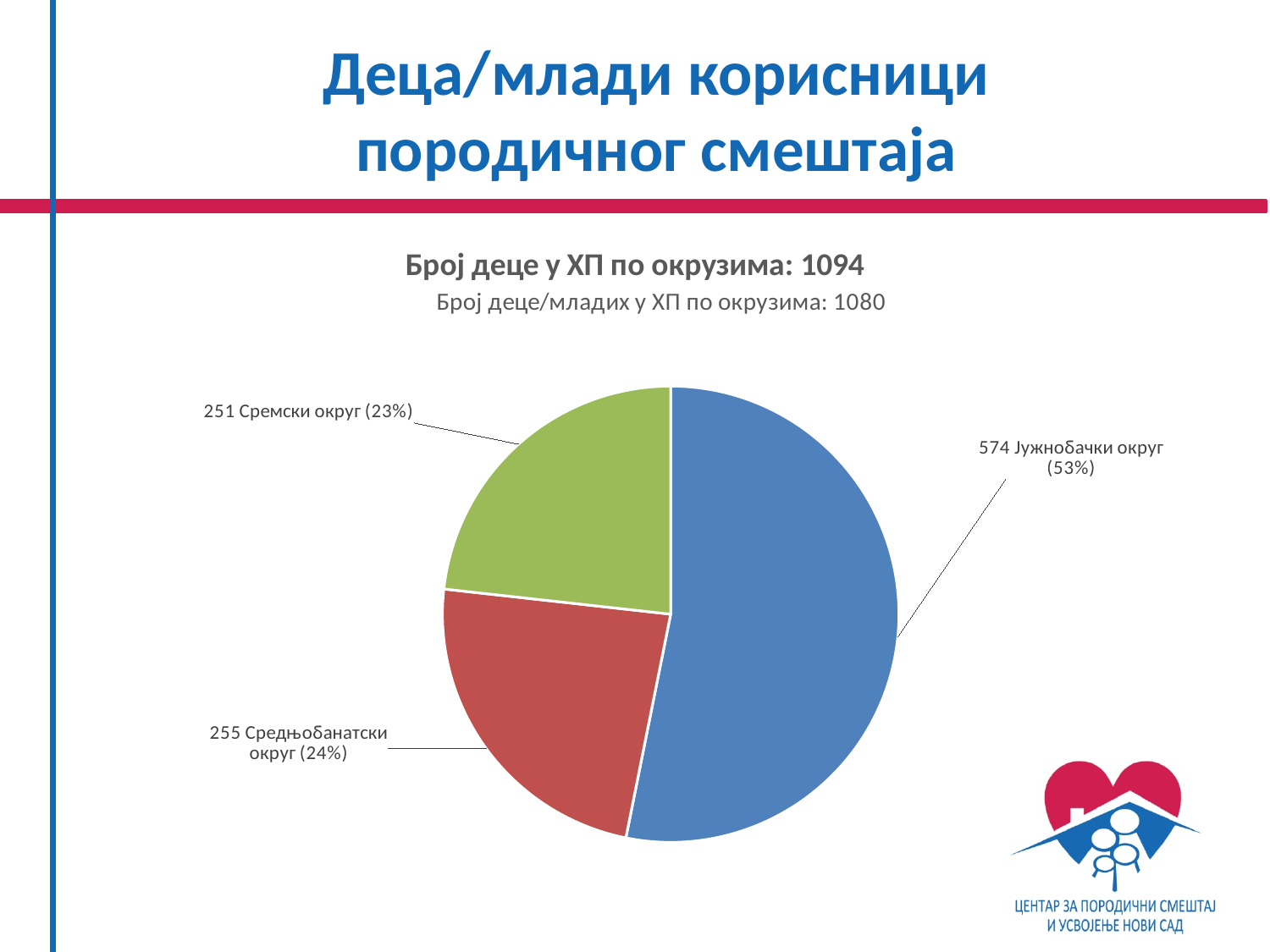
What is the difference between the values for Јужнобачки округ and Сремски округ? 323 What share of the pie does Јужнобачки округ represent? 53% What is the value for Сремски округ? 251 What is the value for Средњобанатски округ? 255 What kind of chart is shown on the slide? pie chart What is the value for Јужнобачки округ? 574 Which district has the largest slice of the pie? Јужнобачки округ Which district has the smallest slice of the pie? Сремски округ What is the title of the chart? Број деце/младих у ХП по окрузима: 1080 What is the difference between the values for Средњобанатски округ and Сремски округ? 4 How many slices does the pie chart have? 3 What share of the pie does Средњобанатски округ represent? 24%